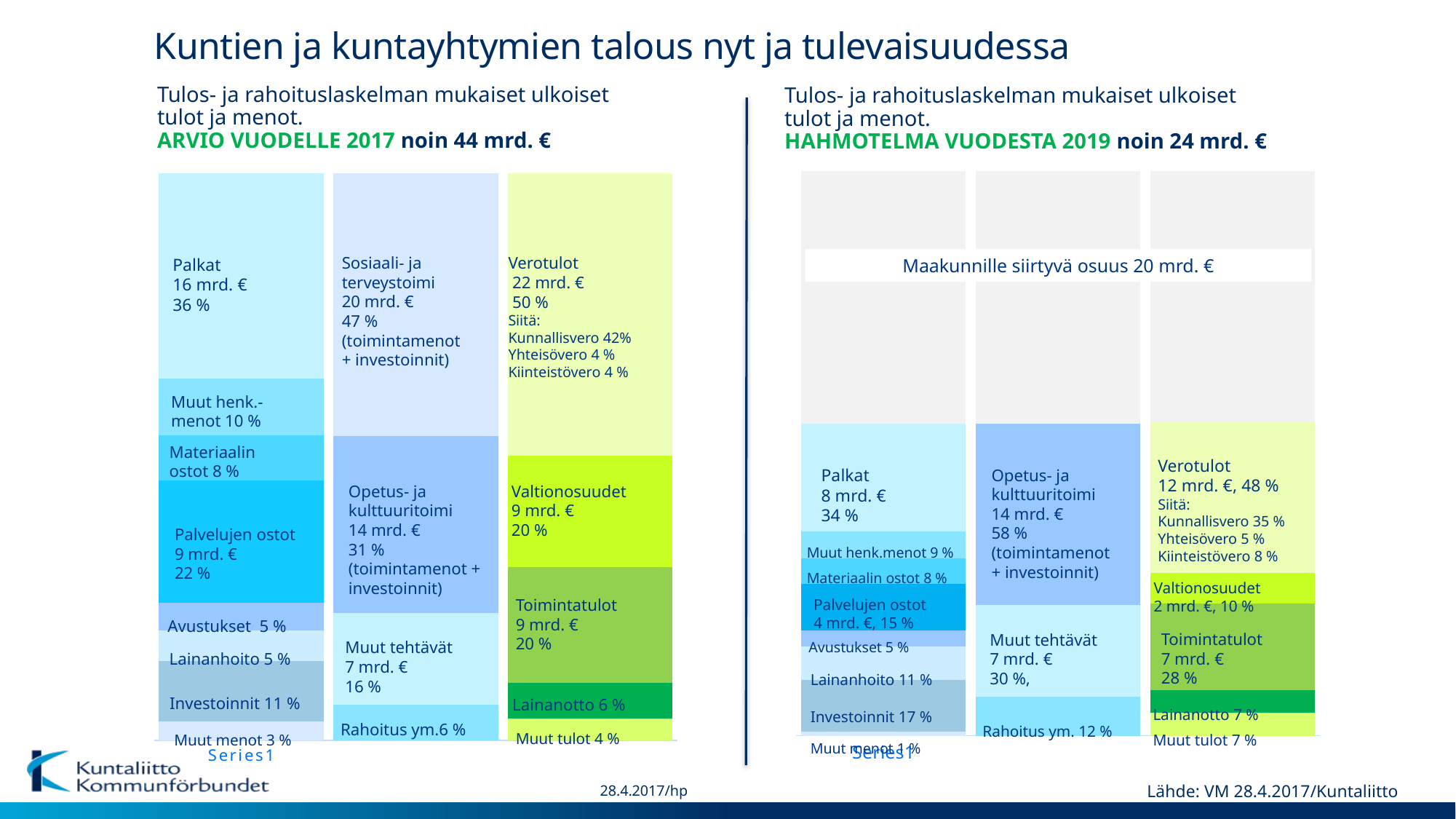
In the right chart (HAHMOTELMA VUODESTA 2019), what is the Maakunnille siirtyvä osuus? 20 mrd. € In the right chart (HAHMOTELMA VUODESTA 2019), what percentage share is shown for Investoinnit? 17 % In the left chart (ARVIO VUODELLE 2017), what percentage share is shown for Sosiaali- ja terveystoimi? 47 % In the left chart (ARVIO VUODELLE 2017), what is the difference in mrd. € between Verotulot and Valtionosuudet? 13 mrd. € In the right chart (HAHMOTELMA VUODESTA 2019), what is the value for Opetus- ja kulttuuritoimi? 14 mrd. € In the left chart (ARVIO VUODELLE 2017), what is the value for Palkat? 16 mrd. € In the left chart (ARVIO VUODELLE 2017), which segment of the income bar has the largest share? Verotulot What kind of chart is shown on the left side of the slide? Stacked bar chart In the right chart (HAHMOTELMA VUODESTA 2019), which is larger: Palkat or Opetus- ja kulttuuritoimi? Opetus- ja kulttuuritoimi How many stacked bars does the right chart (HAHMOTELMA VUODESTA 2019) contain? 3 In the left chart (ARVIO VUODELLE 2017), what is the value for Verotulot? 22 mrd. €